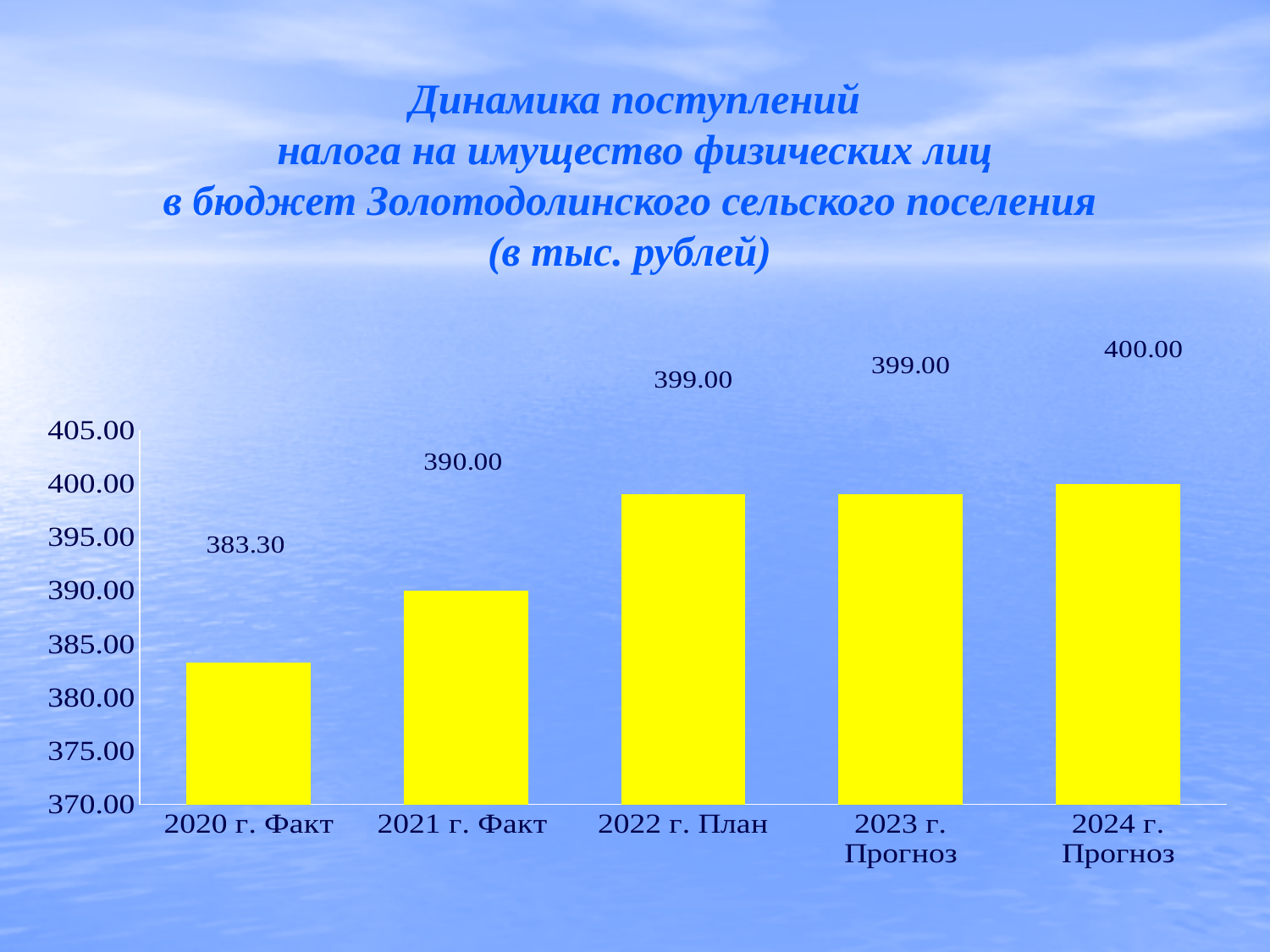
What is the difference between the values for 2021 г. Факт and 2020 г. Факт? 6.70 What is the value for 2021 г. Факт? 390.00 Which category has the lowest value? 2020 г. Факт How many categories are shown on the x axis? 5 What is the value for 2022 г. План? 399.00 What is the value for 2020 г. Факт? 383.30 What is the difference between the values for 2024 г. Прогноз and 2022 г. План? 1.00 What kind of chart is shown on the slide? Bar chart Which category has the highest value? 2024 г. Прогноз Which is larger, the value for 2021 г. Факт or the value for 2022 г. План? 2022 г. План What is the value for 2024 г. Прогноз? 400.00 Do the values rise or fall from 2020 г. Факт to 2024 г. Прогноз? Rise